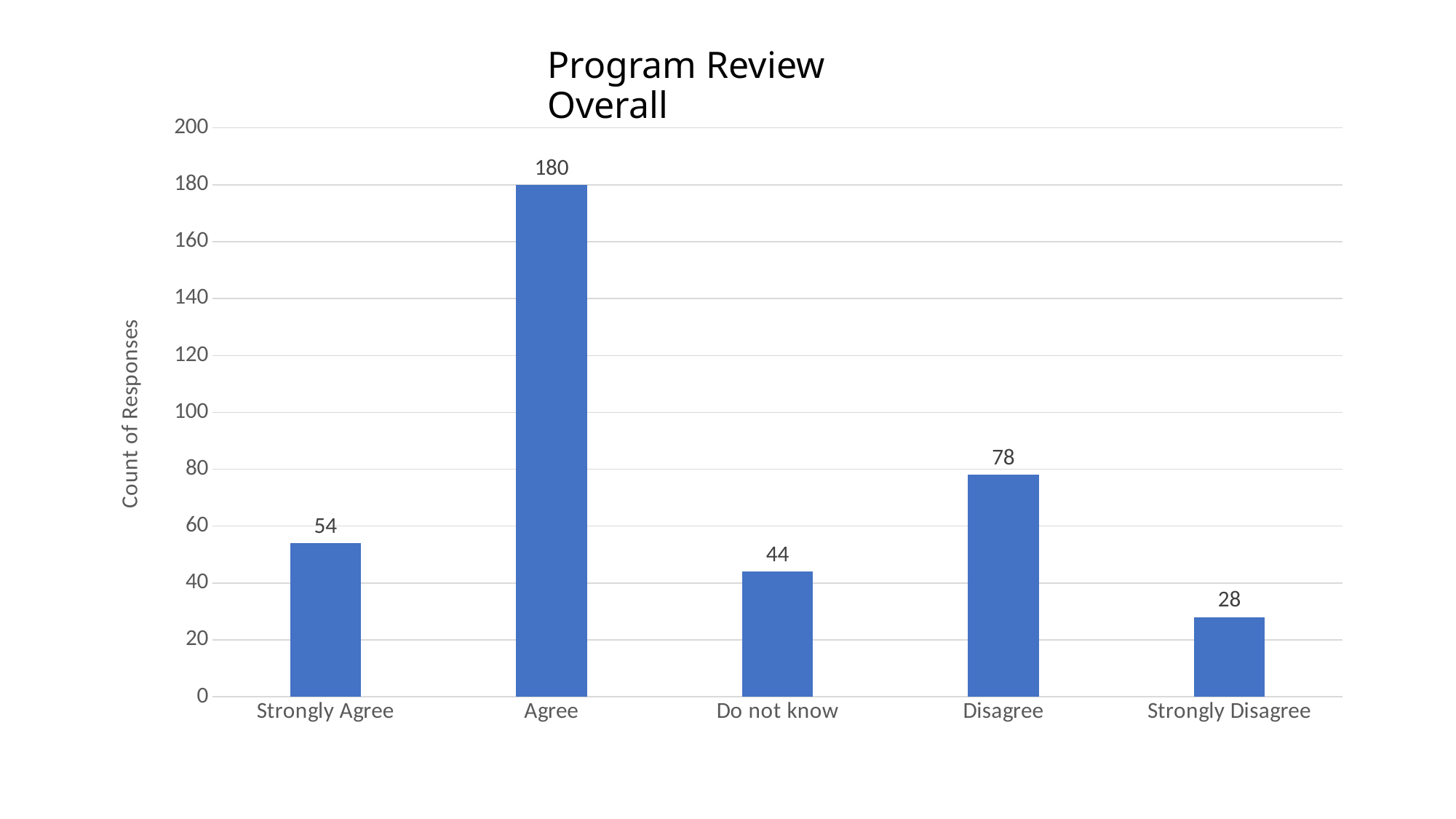
How many categories are shown on the x axis? 5 What kind of chart is shown on the slide? bar chart What is the title of the chart? Program Review Overall Which has more responses, Disagree or Strongly Agree? Disagree What is the difference between the counts for Strongly Agree and Do not know? 10 What is the count of responses for Do not know? 44 What is the count of responses for Agree? 180 Is the value for Disagree greater or less than 100? less What is the difference between the counts for Agree and Disagree? 102 Which category has the lowest count of responses? Strongly Disagree What is the count of responses for Strongly Disagree? 28 Which category has the highest count of responses? Agree